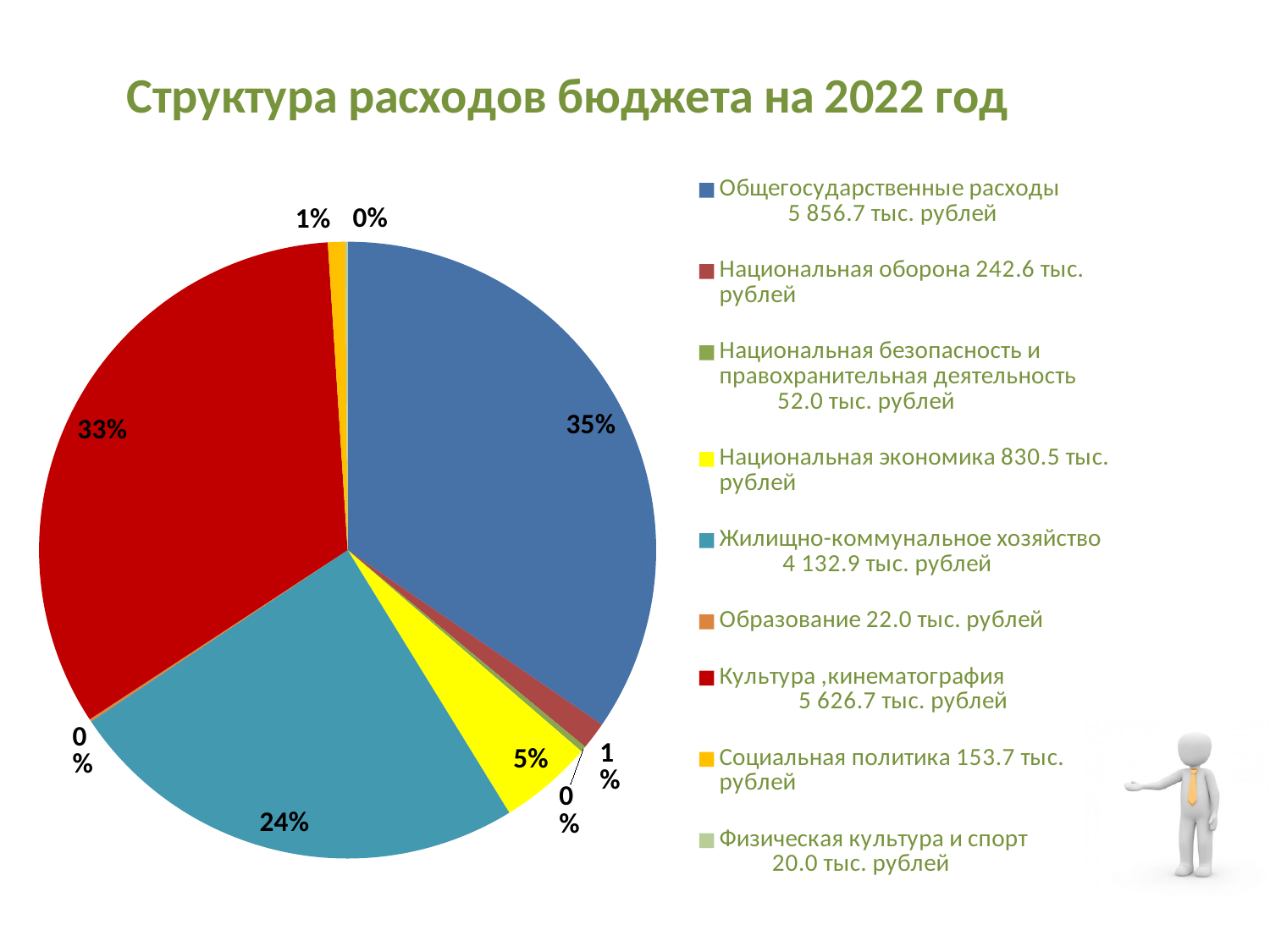
What amount in тыс. рублей does the legend give for Жилищно-коммунальное хозяйство? 4 132.9 тыс. рублей What is the title of the chart? Структура расходов бюджета на 2022 год Which category has the largest slice of the pie? Общегосударственные расходы Which is larger, the slice for Жилищно-коммунальное хозяйство or the slice for Национальная экономика? Жилищно-коммунальное хозяйство What is the difference in percentage points between the Общегосударственные расходы slice and the Культура, кинематография slice? 2% What share of the pie does Жилищно-коммунальное хозяйство take? 24% How many entries does the legend list? 9 What share of the pie does Национальная экономика take? 5% What kind of chart is shown on the slide? Pie chart What share of the pie does Культура, кинематография take? 33% What amount in тыс. рублей does the legend give for Социальная политика? 153.7 тыс. рублей